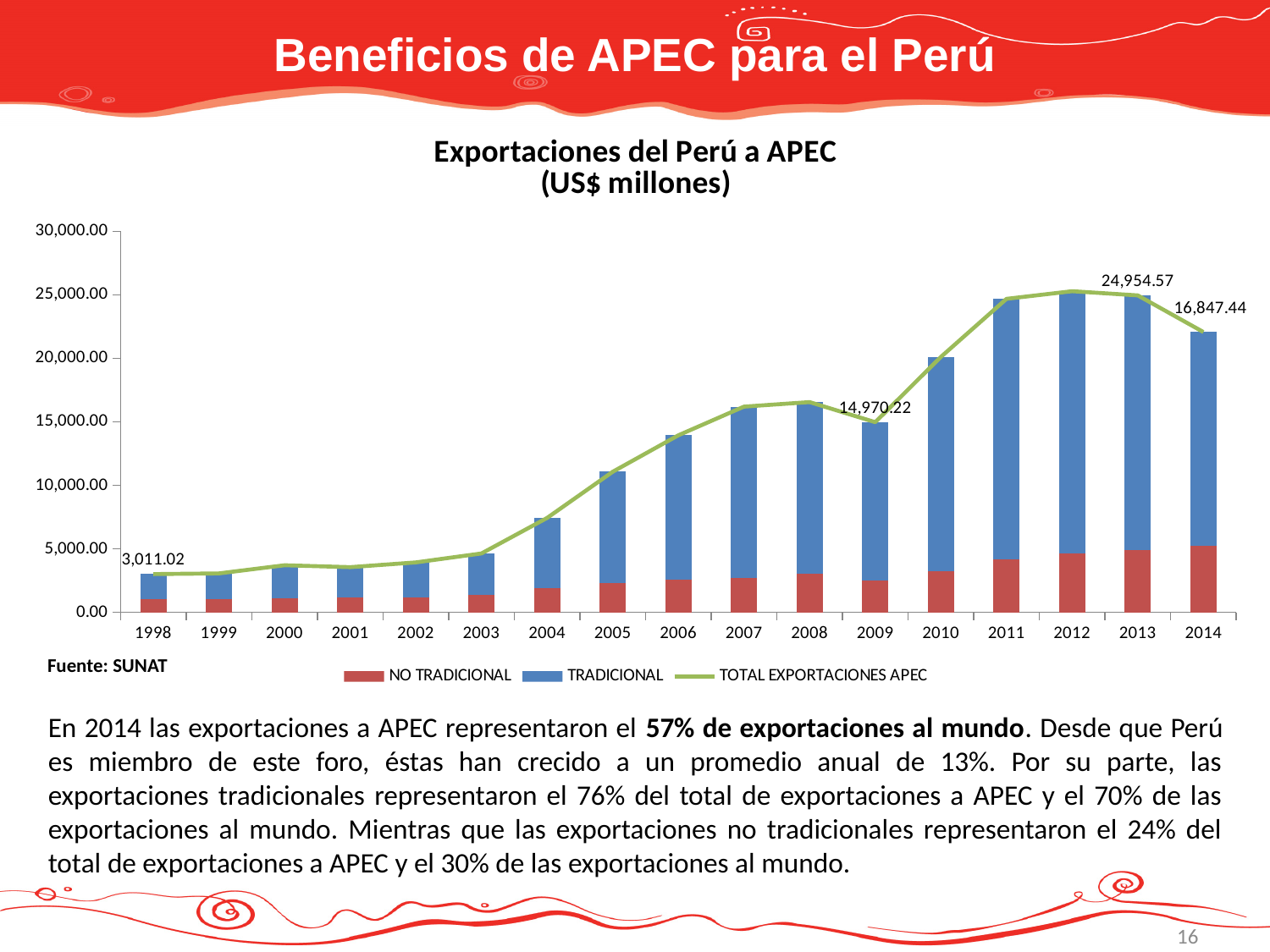
Do total exports to APEC rise or fall from 1998 to 2008? rise How many series does the legend list? 3 What is the labeled value of total exports to APEC in 2009? 14,970.22 Is the total exports value for 2010 greater or less than 15,000.00? greater What is the labeled value of total exports to APEC in 1998? 3,011.02 What is the difference between the labeled total for 2009 and the labeled total for 1998? 11,959.20 Is the total exports value for 2006 greater or less than 10,000.00? greater How many years are shown on the x axis? 17 What kind of chart is shown on the slide? bar chart with a line Which year has the larger total exports to APEC, 2009 or 2010? 2010